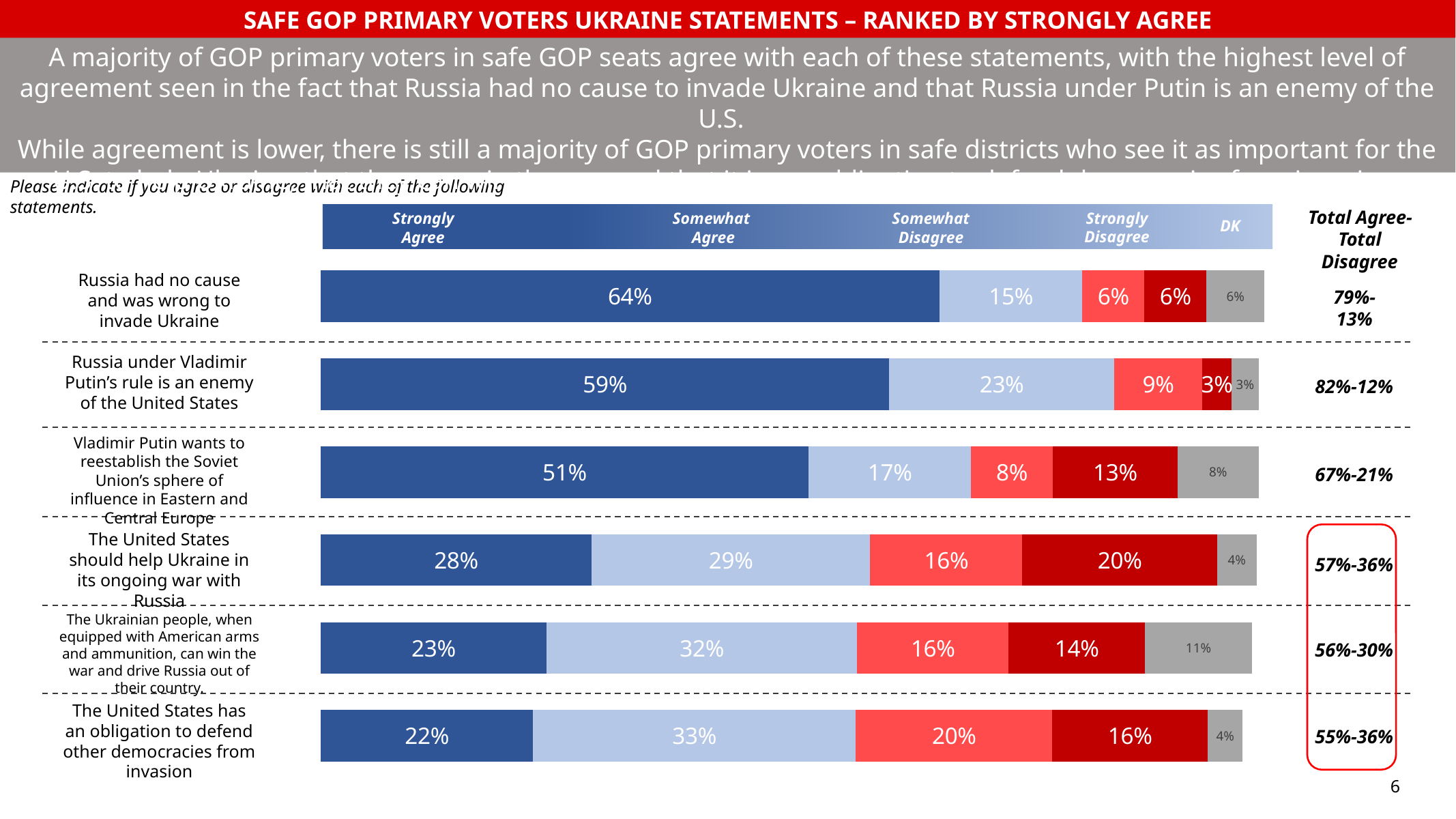
Which statement has the highest Strongly Disagree percentage? The United States should help Ukraine in its ongoing war with Russia What is the DK (don't know) value for the statement that the Ukrainian people, when equipped with American arms and ammunition, can win the war? 11% How many response categories does the chart legend list? 5 What is the difference in Strongly Agree between the statement that Russia had no cause to invade Ukraine and the statement that Russia under Putin is an enemy of the United States? 5 percentage points Which has a higher Strongly Disagree value: the statement that the United States should help Ukraine in its war, or the statement that the Ukrainian people can win the war with American arms? The United States should help Ukraine in its ongoing war with Russia Which statement has the lowest Strongly Agree percentage? The United States has an obligation to defend other democracies from invasion What is the Strongly Disagree value for the statement that Vladimir Putin wants to reestablish the Soviet Union's sphere of influence in Eastern and Central Europe? 13% Which statement has the highest Strongly Agree percentage? Russia had no cause and was wrong to invade Ukraine What type of chart is used on this slide? Stacked bar chart How many statements are shown in the chart? 6 What is the Somewhat Agree value for the statement that Russia under Vladimir Putin's rule is an enemy of the United States? 23% What percentage of safe GOP primary voters strongly agree that Russia had no cause and was wrong to invade Ukraine? 64%